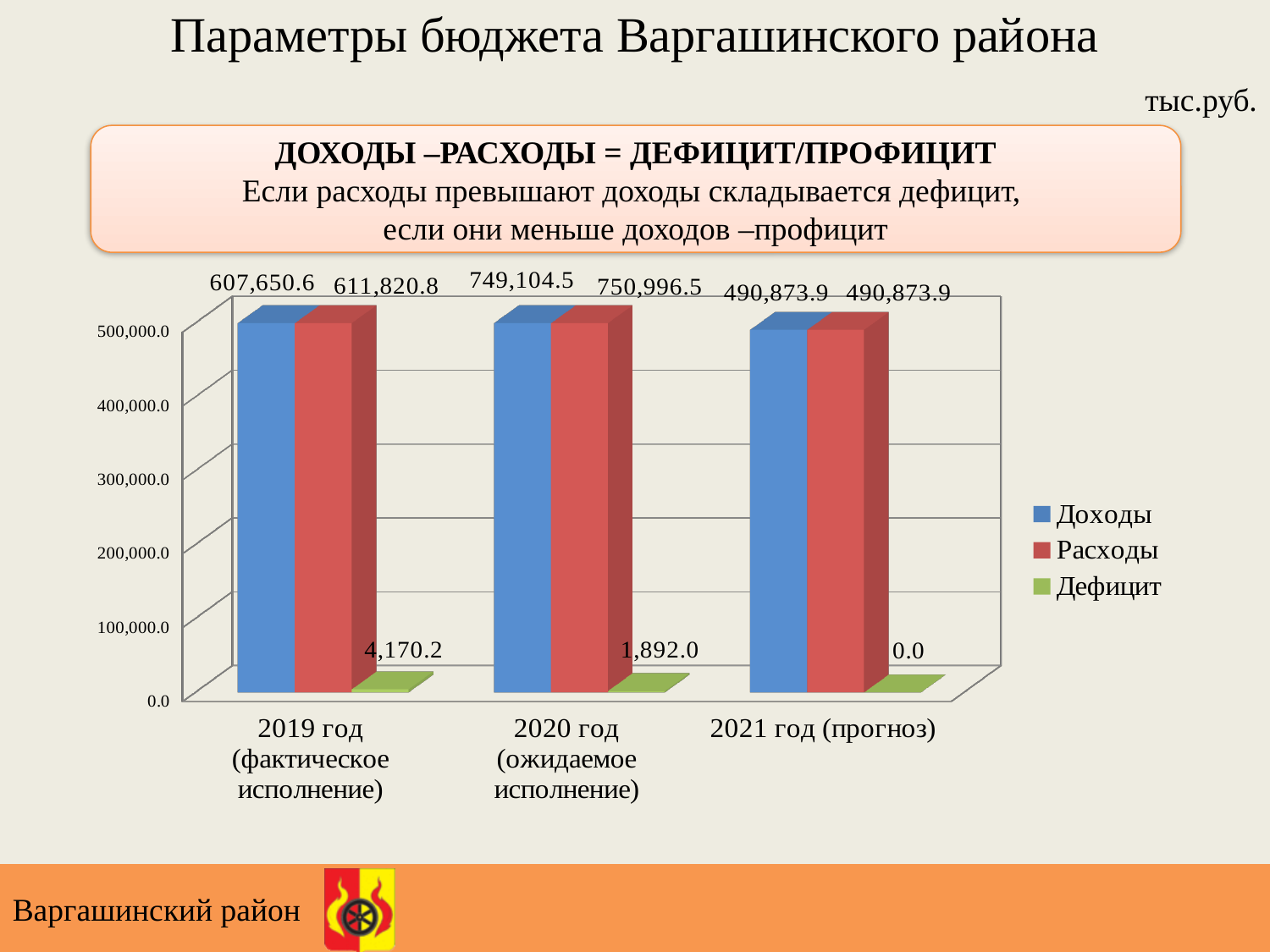
What is the value of Дефицит for 2021 год (прогноз)? 0.0 What is the difference between Расходы and Доходы in 2019 год (фактическое исполнение)? 4,170.2 How many year categories are shown on the x axis? 3 How many series does the legend list? 3 What is the value of Расходы for 2020 год (ожидаемое исполнение)? 750,996.5 What kind of chart is shown on the slide? Bar chart What is the value of Доходы for 2019 год (фактическое исполнение)? 607,650.6 Does the value of Дефицит rise or fall from 2019 to 2021? Fall In which year is Доходы the lowest? 2021 год (прогноз) Which is larger in 2020 год (ожидаемое исполнение): Доходы or Расходы? Расходы In which year is Расходы the highest? 2020 год (ожидаемое исполнение) What is the value of Доходы for 2021 год (прогноз)? 490,873.9